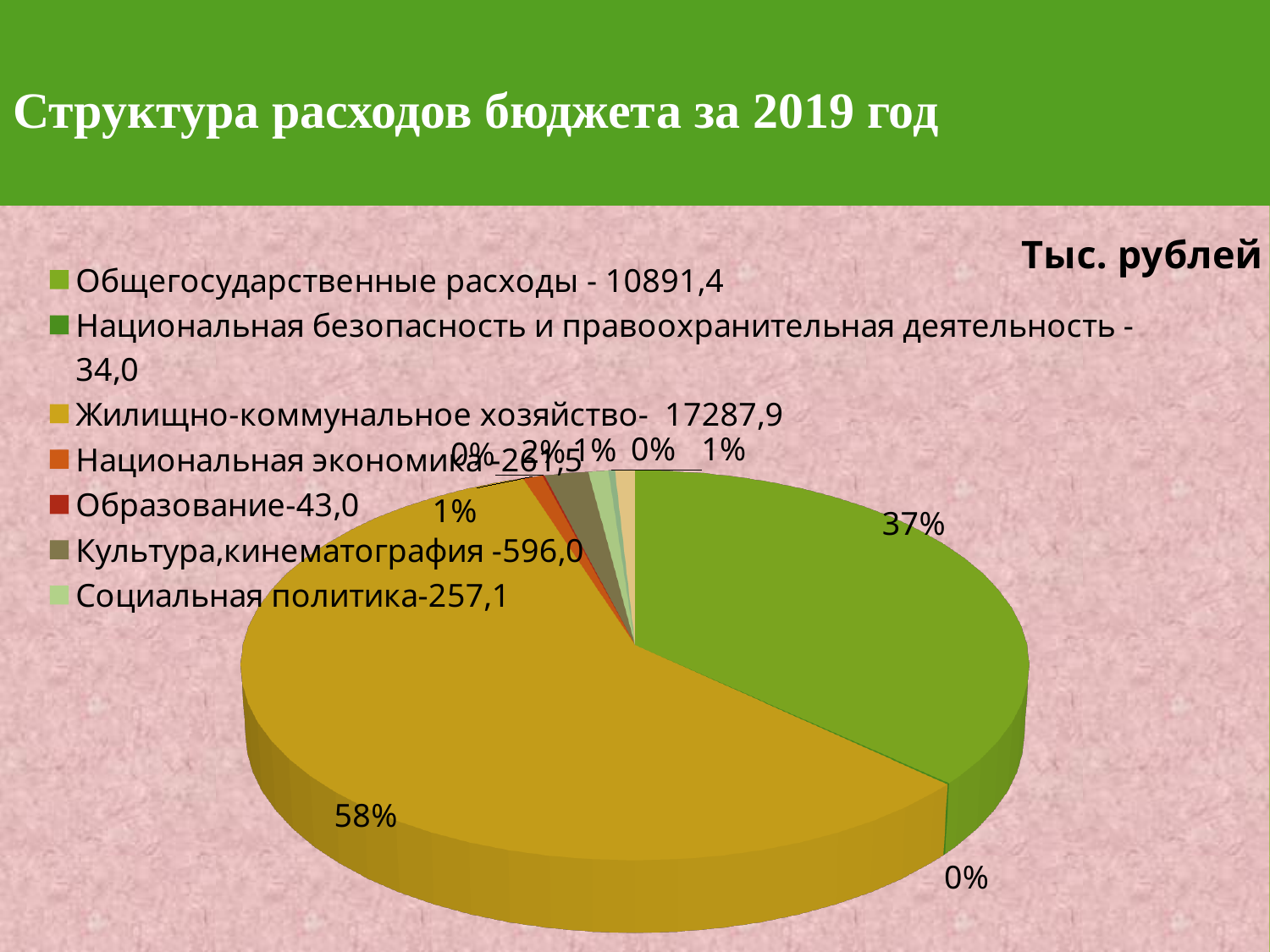
What kind of chart is shown on the slide? pie chart Which is larger, Национальная экономика or Социальная политика? Национальная экономика Which category has the largest share of the pie? Жилищно-коммунальное хозяйство What value does the legend give for Культура,кинематография? 596,0 What value does the legend give for Образование? 43,0 What is the difference between the values for Жилищно-коммунальное хозяйство and Общегосударственные расходы? 6396,5 How many categories does the legend list? 7 What share of the pie does Общегосударственные расходы take? 37% What value does the legend give for Общегосударственные расходы? 10891,4 What is the title of the slide's chart? Тыс. рублей What share of the pie does Жилищно-коммунальное хозяйство take? 58% What value does the legend give for Жилищно-коммунальное хозяйство? 17287,9